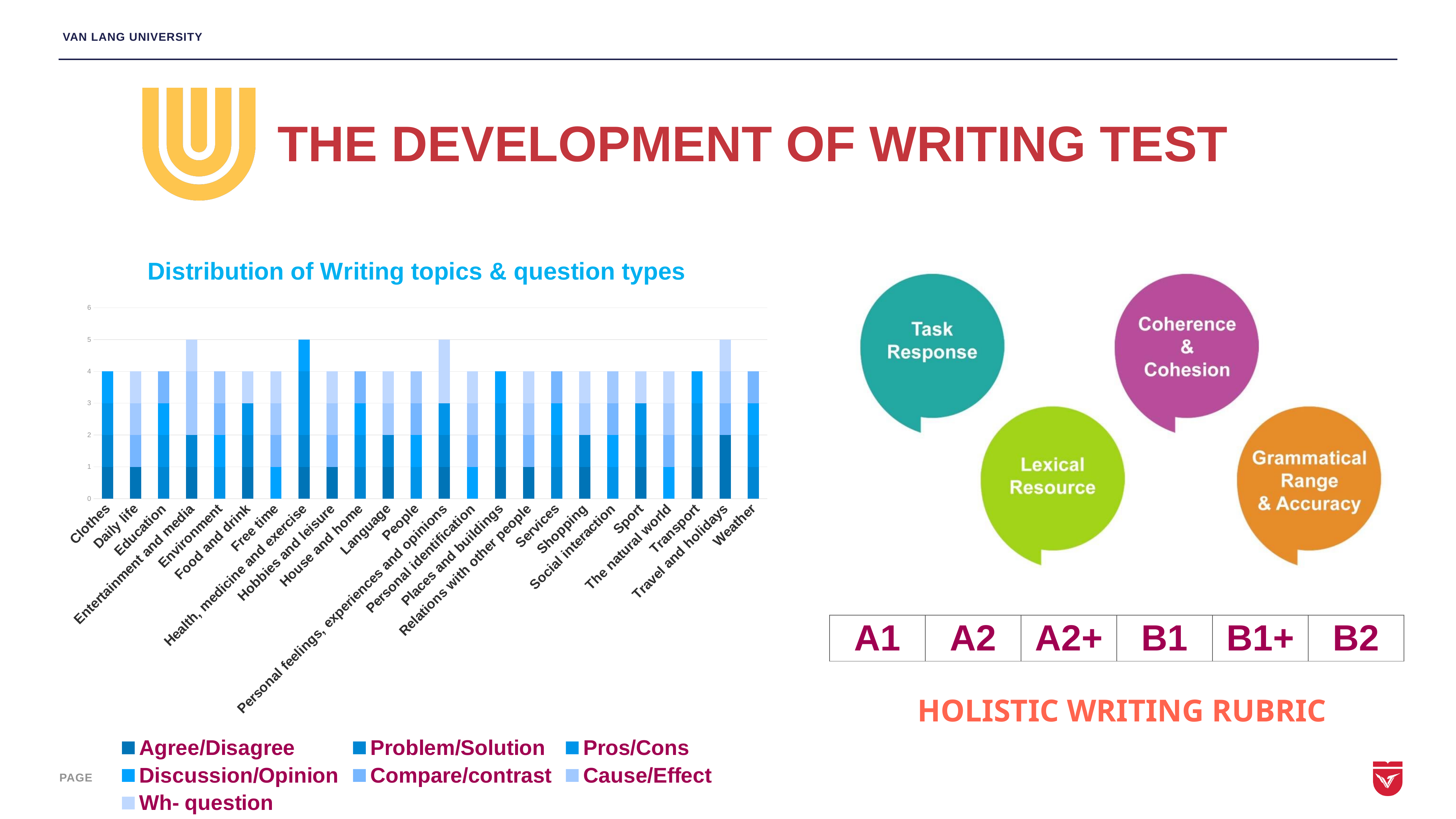
Which legend entry is listed first in the chart's legend? Agree/Disagree How many topic categories are shown along the x axis of the chart? 24 What is the title of the chart on the slide? Distribution of Writing topics & question types Is the total for Weather greater or less than 5? less Which has a taller stacked bar, Health, medicine and exercise or Sport? Health, medicine and exercise What is the total height of the stacked bar for Travel and holidays? 5 What is the total height of the stacked bar for Clothes? 4 What kind of chart is shown on the slide? Stacked bar chart Is the total for Entertainment and media greater or less than 4? greater What is the difference between the total for Personal feelings, experiences and opinions and the total for People? 1 What is the total height of the stacked bar for Health, medicine and exercise? 5 How many series does the chart's legend list? 7